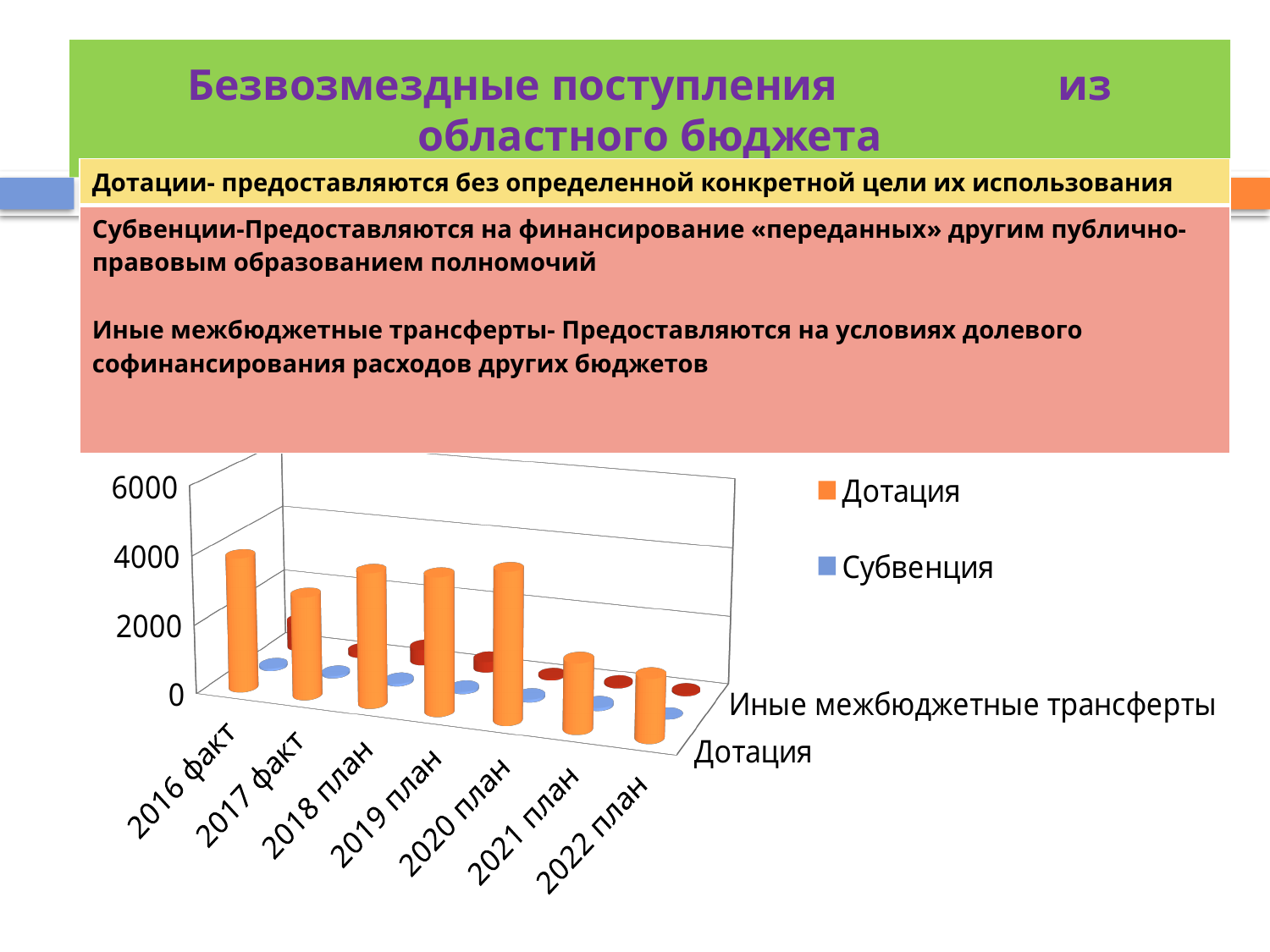
Is the Дотация value for 2017 факт greater or less than 2000? greater Is the Субвенция value for 2016 факт greater or less than 2000? less Do the Дотация values rise or fall from 2020 план to 2022 план? fall Is the Дотация value for 2018 план greater or less than 4000? less How many categories are shown along the x axis of the chart? 7 How many series does the chart legend list? 2 What kind of chart is shown on the slide? bar chart Which category has the highest Дотация value? 2020 план Which category has the lowest Дотация value? 2022 план What colour represents the Дотация series in the legend? orange Which is larger, the Дотация value for 2016 факт or for 2017 факт? 2016 факт